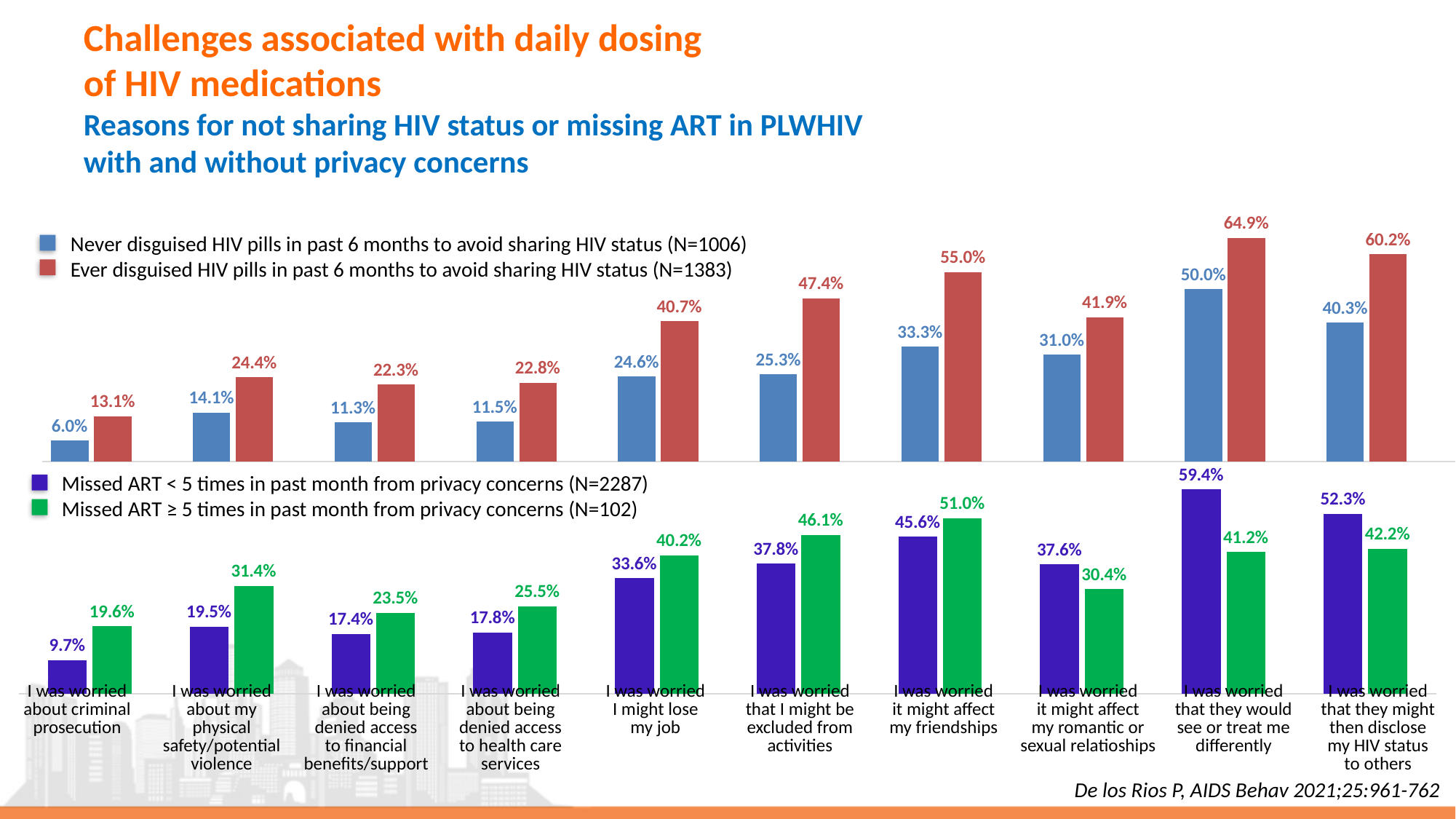
How many series does the legend of the top chart list? 2 In the bottom chart, what is the value for 'Missed ART ≥ 5 times' for 'I was worried it might affect my friendships'? 51.0% In the top chart, what percentage of the 'Ever disguised HIV pills' group was worried that they would see or treat me differently? 64.9% In the top chart, what is the difference between the 'Ever disguised' and 'Never disguised' values for 'I was worried that I might be excluded from activities'? 22.1% In the bottom chart, which category has the highest value for 'Missed ART < 5 times in past month from privacy concerns'? I was worried that they would see or treat me differently What type of chart is used on this slide? Bar chart In the bottom chart, for 'I was worried it might affect my romantic or sexual relationships', which series has the larger value: 'Missed ART < 5 times' or 'Missed ART ≥ 5 times'? Missed ART < 5 times In the bottom chart, what is the sample size (N) given in the legend for 'Missed ART ≥ 5 times in past month from privacy concerns'? N=102 How many categories are shown along the x axis of the charts? 10 In the bottom chart, what is the difference between the two series for 'I was worried that they would see or treat me differently'? 18.2% In the top chart, what is the value for 'Never disguised HIV pills' for 'I was worried about criminal prosecution'? 6.0% In the top chart, which category has the lowest value for 'Ever disguised HIV pills in past 6 months'? I was worried about criminal prosecution